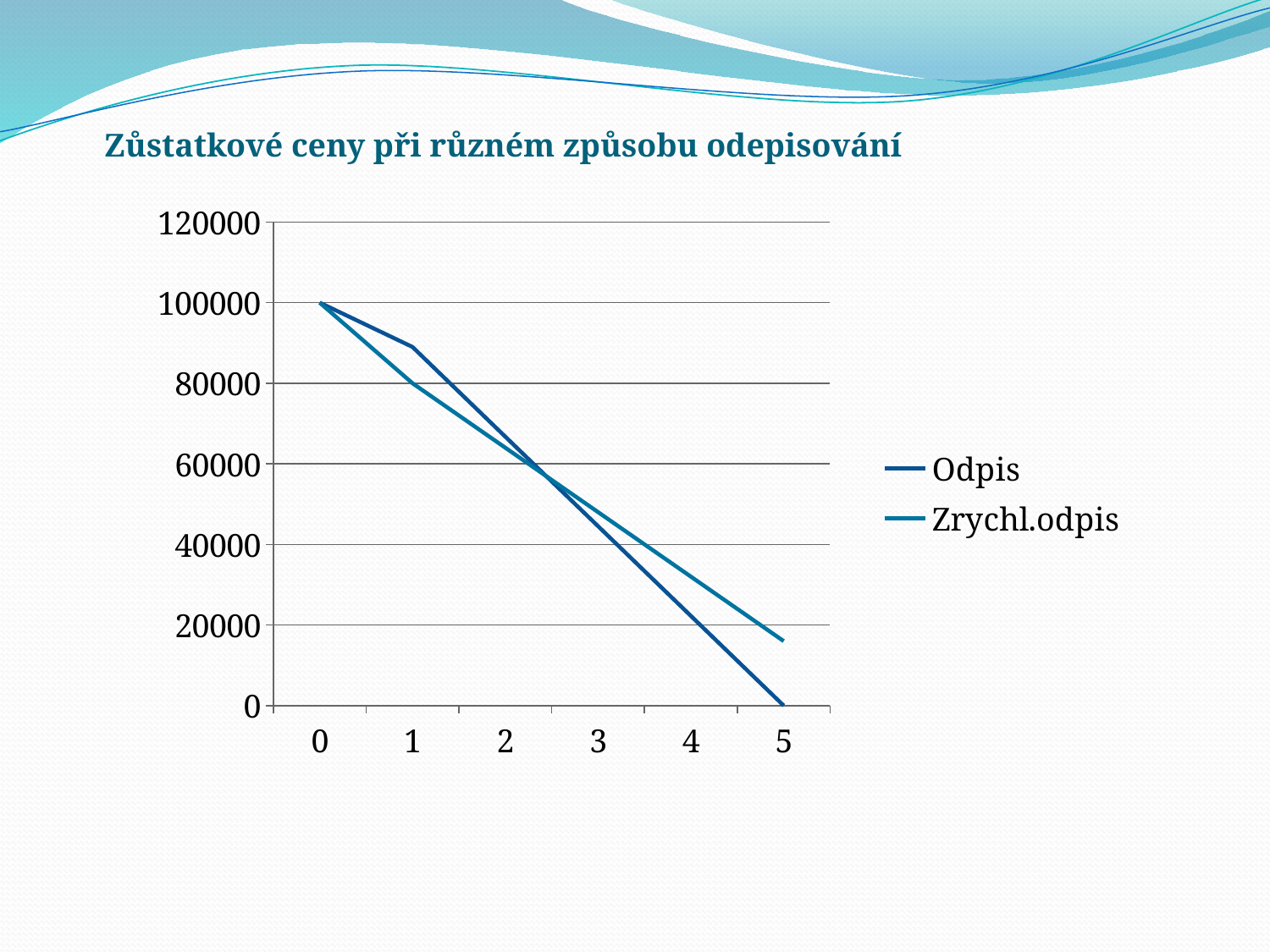
At x = 4, which series has the higher value, Odpis or Zrychl.odpis? Zrychl.odpis What is the value of the Odpis series at x = 5? 0 What is the title of the chart? Zůstatkové ceny při různém způsobu odepisování Is the value of Zrychl.odpis at x = 5 greater or less than 20000? less How many series does the legend list? 2 At x = 1, which series has the higher value, Odpis or Zrychl.odpis? Odpis What are the two series named in the legend? Odpis and Zrychl.odpis What kind of chart is shown on the slide? line chart Is the value of Odpis at x = 1 greater or less than 80000? greater What is the value of the Odpis series at x = 0? 100000 What is the value of the Zrychl.odpis series at x = 0? 100000 Do the values of the Odpis series rise or fall along the x axis? fall